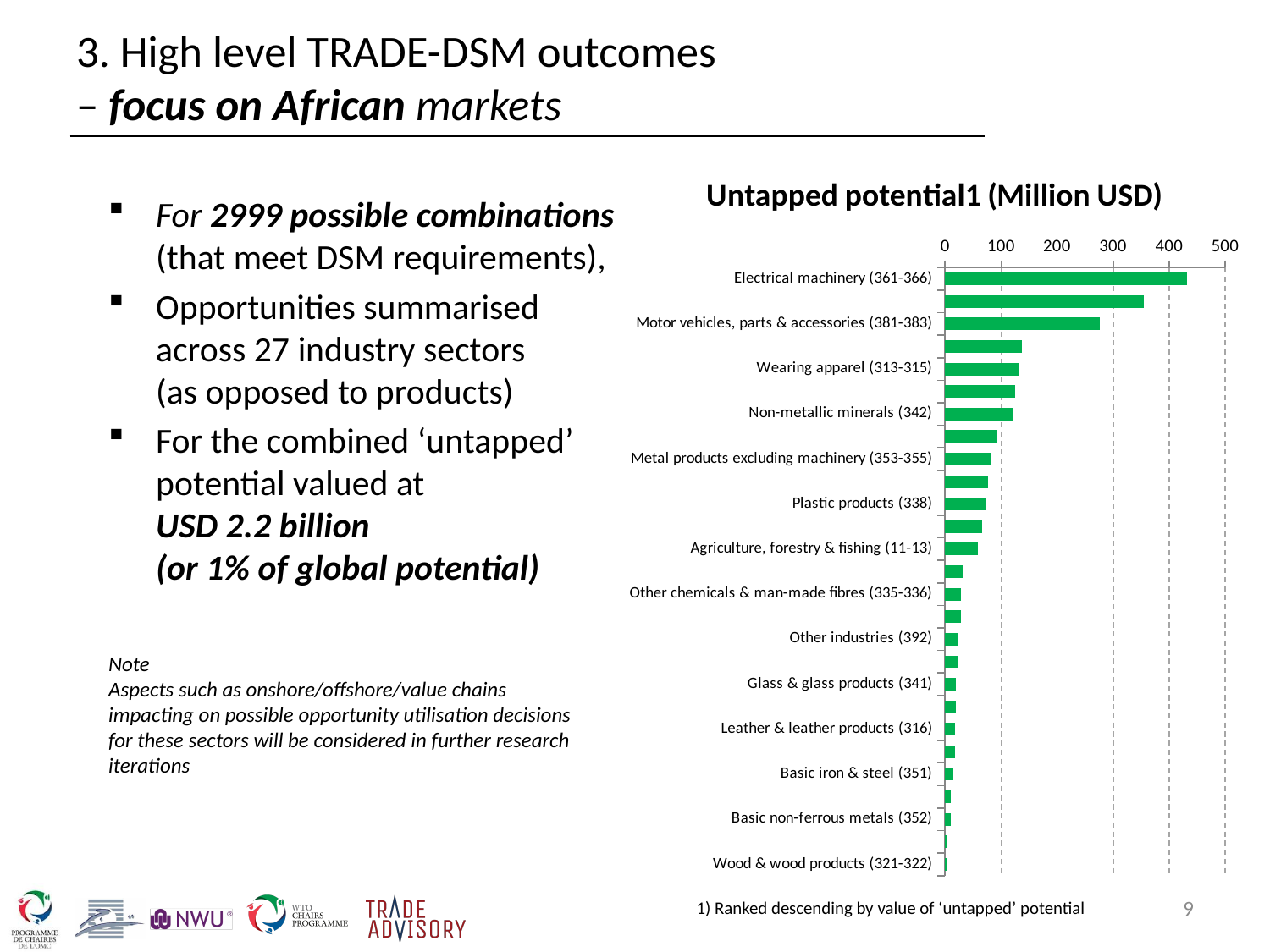
What kind of chart is shown on the slide? Bar chart Is the value for Electrical machinery (361-366) greater or less than 400? greater What is the title of the chart? Untapped potential1 (Million USD) Which has the larger untapped potential: Wearing apparel (313-315) or Plastic products (338)? Wearing apparel (313-315) Is the value for Wearing apparel (313-315) greater or less than 100? greater Which has the larger untapped potential: Electrical machinery (361-366) or Motor vehicles, parts & accessories (381-383)? Electrical machinery (361-366) Which sector has the highest untapped potential in the chart? Electrical machinery (361-366) Is the value for Plastic products (338) greater or less than 100? less Which sector has the lowest untapped potential in the chart? Wood & wood products (321-322) Do the bar values increase or decrease going from the top of the chart to the bottom? Decrease